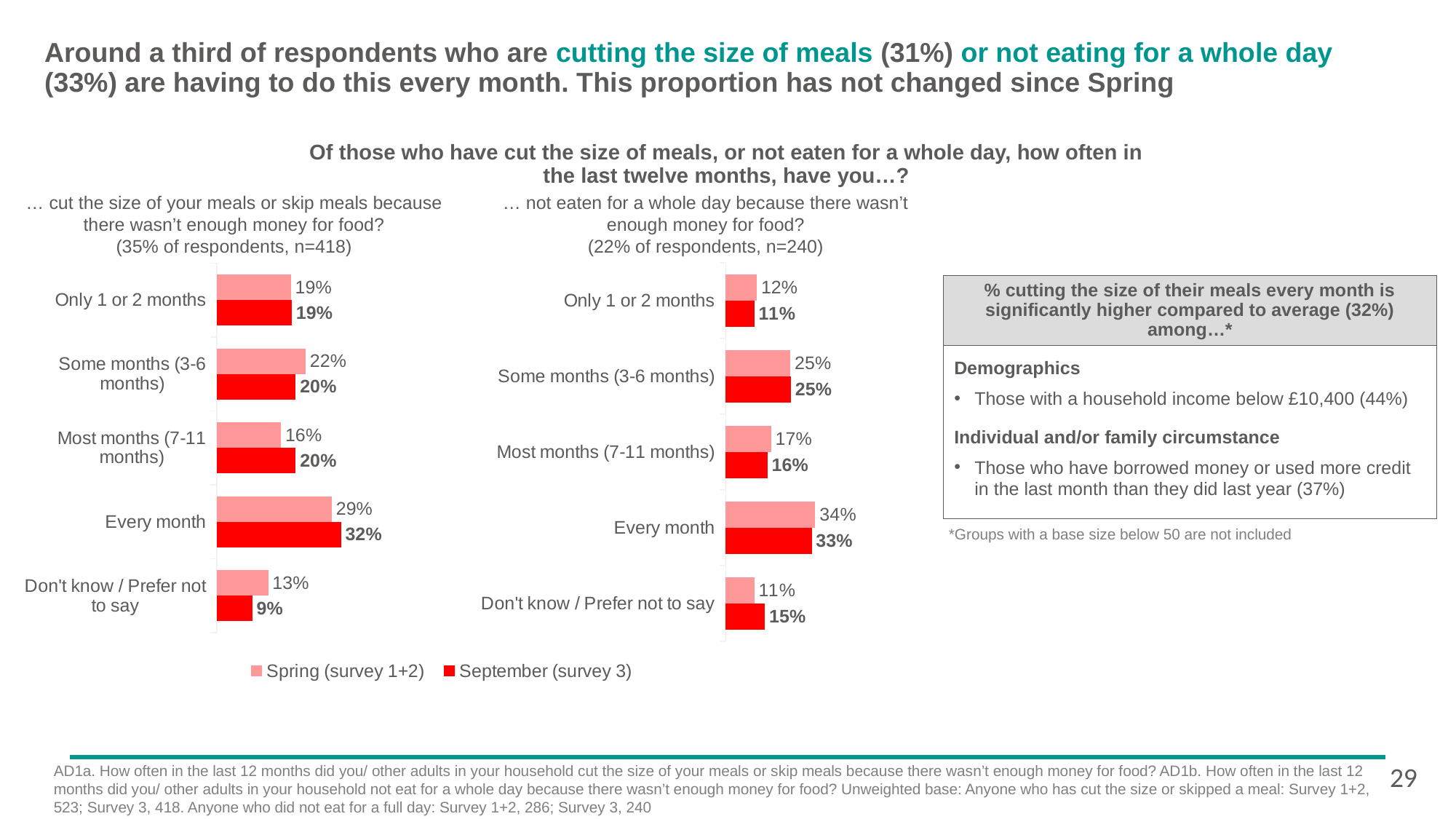
What type of chart is used on this slide? Bar chart In the right chart (not eaten for a whole day), which is larger for Most months (7-11 months): the Spring value or the September value? Spring (17%) How many series does the legend list? 2 In the right chart (not eaten for a whole day), what is the Spring (survey 1+2) value for Some months (3-6 months)? 25% In the right chart (not eaten for a whole day), which category has the highest September (survey 3) value? Every month In the left chart (cut the size of your meals or skip meals), what is the September (survey 3) value for Every month? 32% In the right chart (not eaten for a whole day), what is the difference between the September and Spring values for Don't know / Prefer not to say? 4 percentage points In the left chart (cut the size of your meals or skip meals), what is the Spring (survey 1+2) value for Don't know / Prefer not to say? 13% How many categories are shown in the left chart (cut the size of your meals or skip meals)? 5 In the left chart (cut the size of your meals or skip meals), what is the difference between the September and Spring values for Every month? 3 percentage points In the left chart (cut the size of your meals or skip meals), which category has the lowest September (survey 3) value? Don't know / Prefer not to say In the left chart (cut the size of your meals or skip meals), is the Spring value for Some months (3-6 months) larger or smaller than the September value? larger